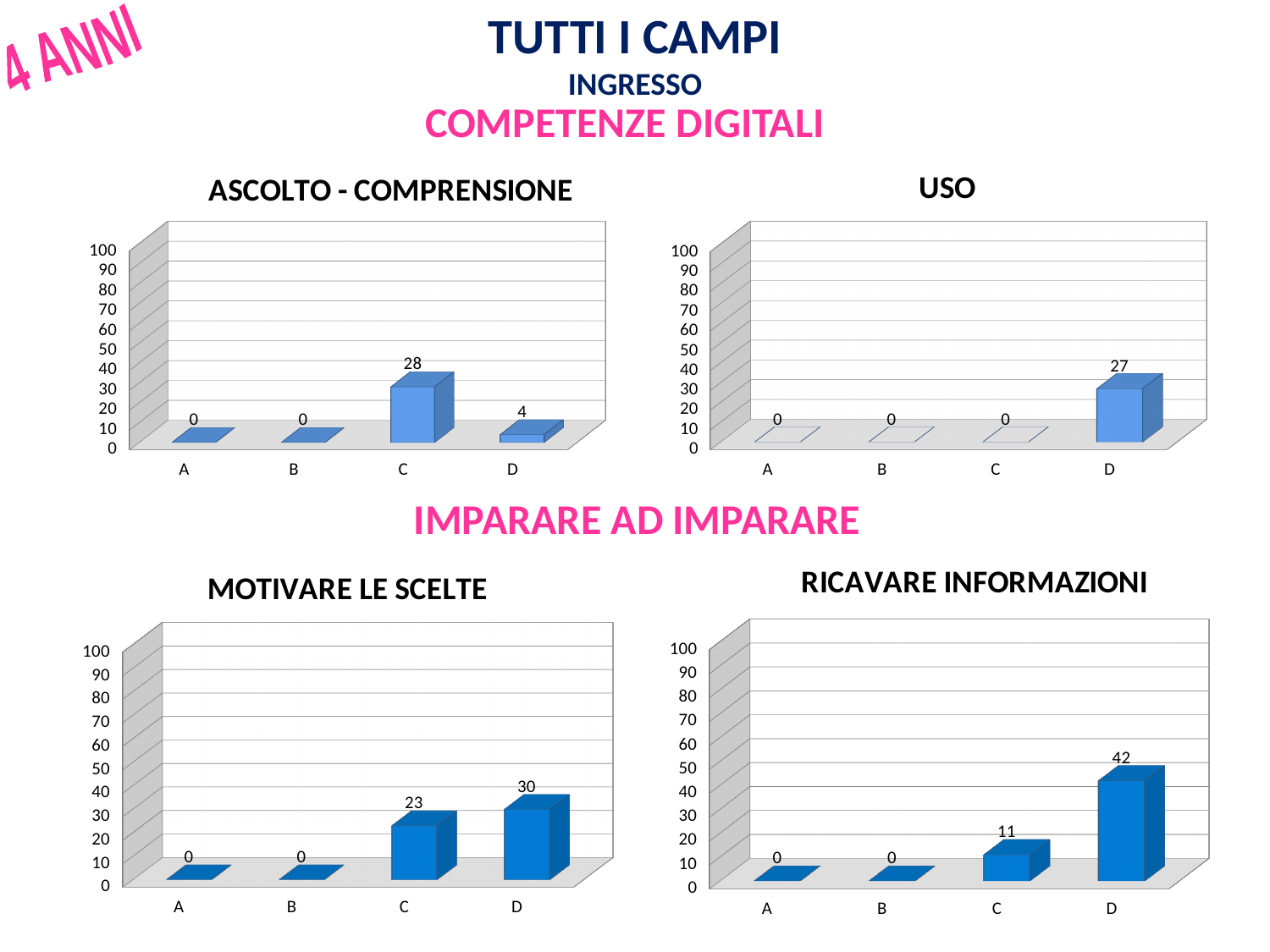
In the ASCOLTO - COMPRENSIONE chart, what is the value for category D? 4 What kind of chart is the USO chart? Bar chart In the USO chart, which category has the highest value? D In the RICAVARE INFORMAZIONI chart, is the value for D greater or less than 40? greater In the ASCOLTO - COMPRENSIONE chart, what is the value for category C? 28 How many categories are shown on the x axis of the ASCOLTO - COMPRENSIONE chart? 4 In the USO chart, what is the value for category D? 27 In the MOTIVARE LE SCELTE chart, what is the difference between the values for D and C? 7 In the MOTIVARE LE SCELTE chart, which is larger, the value for C or the value for D? D In the RICAVARE INFORMAZIONI chart, which category has the highest value? D In the ASCOLTO - COMPRENSIONE chart, what is the difference between the values for C and D? 24 In the RICAVARE INFORMAZIONI chart, what is the value for category C? 11